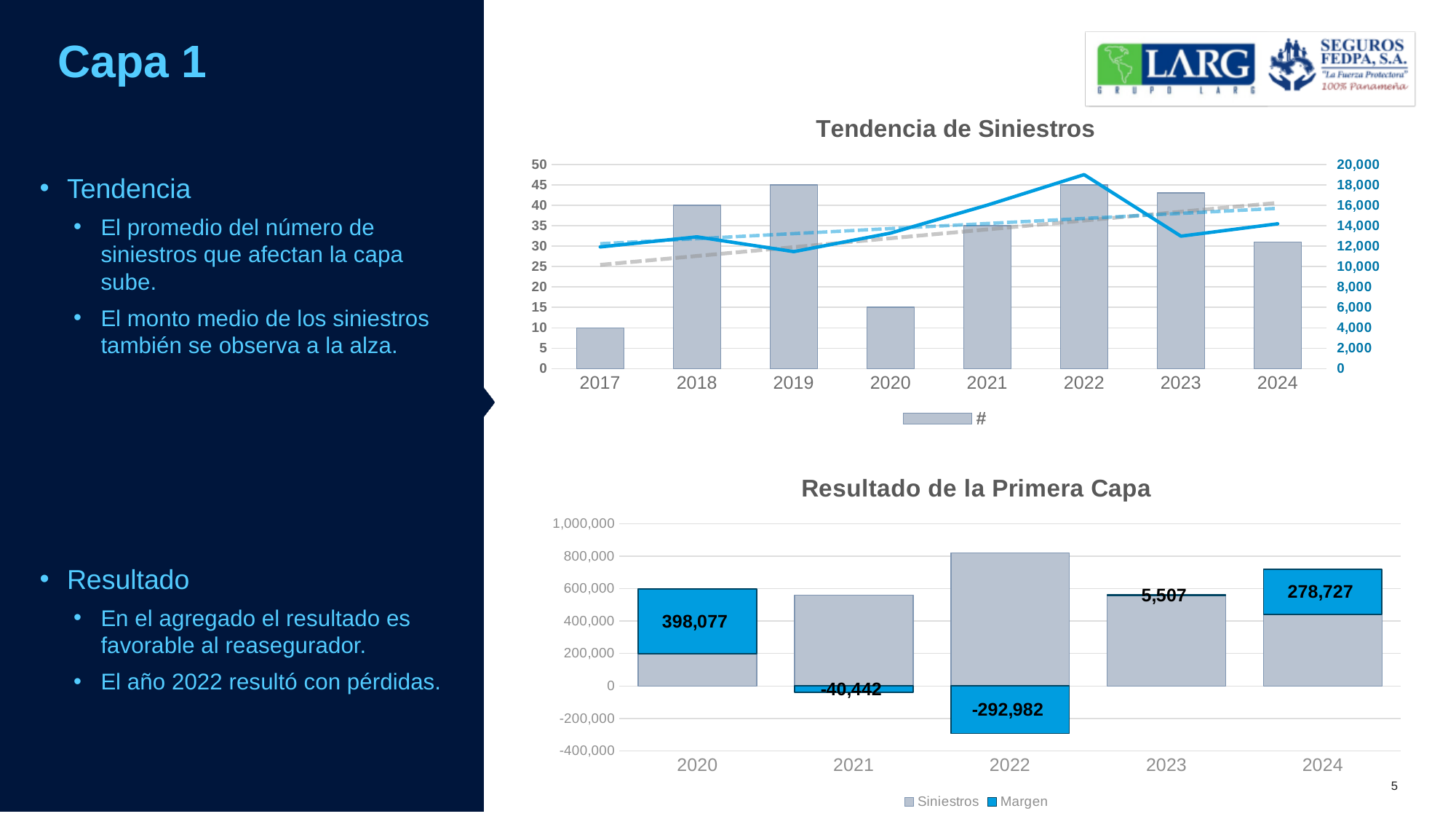
What kind of chart is 'Resultado de la Primera Capa'? Stacked bar chart In the 'Resultado de la Primera Capa' chart, what is the Margen value for 2022? -292,982 In the 'Tendencia de Siniestros' chart, how many years are shown on the x axis? 8 In the 'Tendencia de Siniestros' chart, is the bar for 2023 greater or less than 40? greater In the 'Tendencia de Siniestros' chart, which year has the lowest bar? 2017 How many series does the legend of the 'Resultado de la Primera Capa' chart list? 2 In the 'Resultado de la Primera Capa' chart, what is the difference between the Margen values for 2020 and 2024? 119,350 In the 'Resultado de la Primera Capa' chart, which year has the lowest Margen value? 2022 In the 'Tendencia de Siniestros' chart, which bar is taller, 2019 or 2020? 2019 In the 'Tendencia de Siniestros' chart, what is the value of the bar for 2020? 15 In the 'Resultado de la Primera Capa' chart, what is the Margen value for 2020? 398,077 In the 'Tendencia de Siniestros' chart, what is the value of the bar for 2017? 10